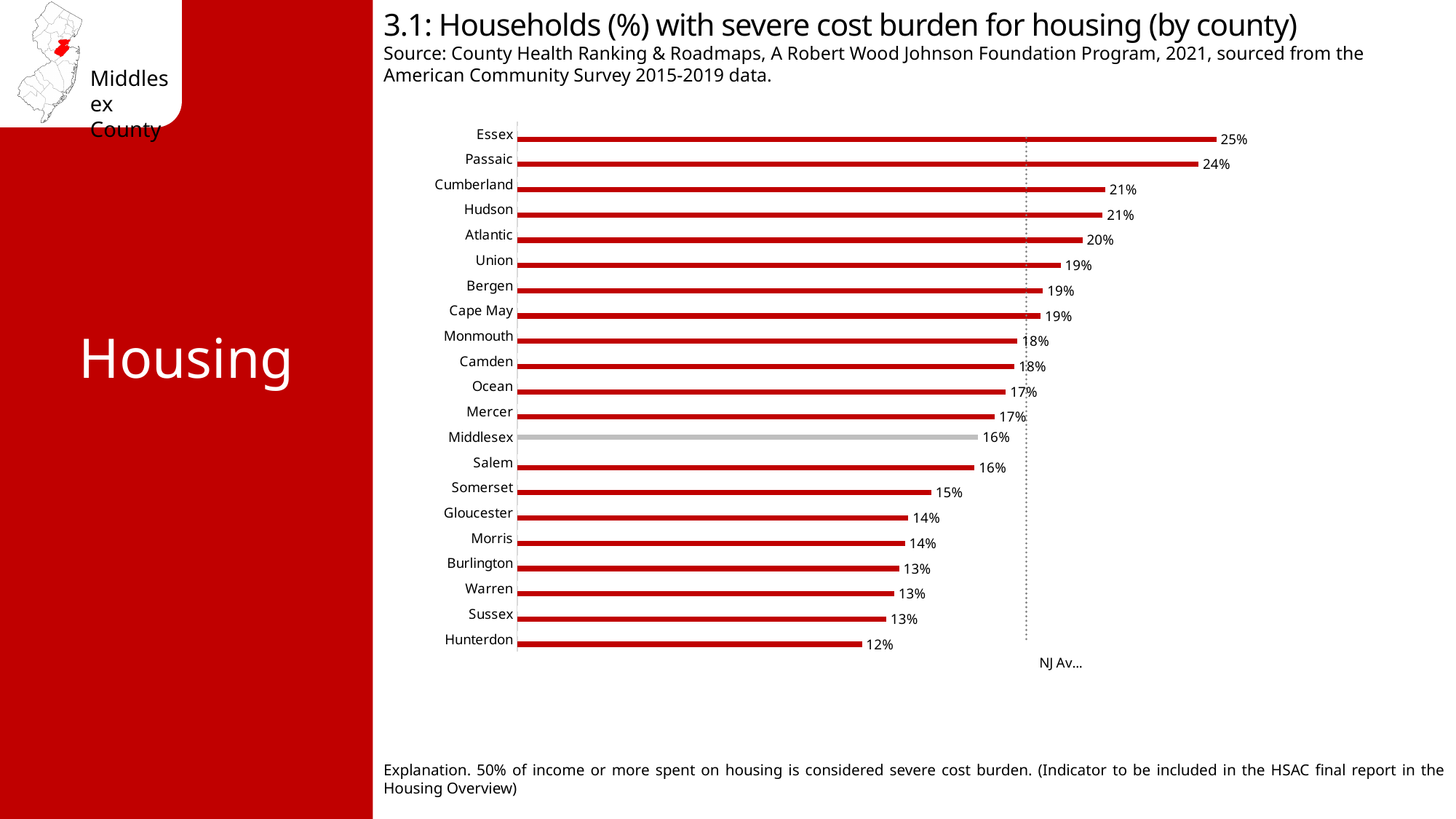
What is the value for Hunterdon? 12% What is the value for Middlesex? 16% Which county's bar is shown in grey rather than red? Middlesex Which is larger, the value for Somerset or the value for Burlington? Somerset What is the value for Atlantic? 20% What is the difference between the values for Passaic and Middlesex? 8% What is the difference between the values for Essex and Hunterdon? 13% What kind of chart is shown on the slide? Bar chart What is the value for Essex? 25% Which county has the highest value? Essex Which county has the lowest value? Hunterdon How many counties are shown in the chart? 21